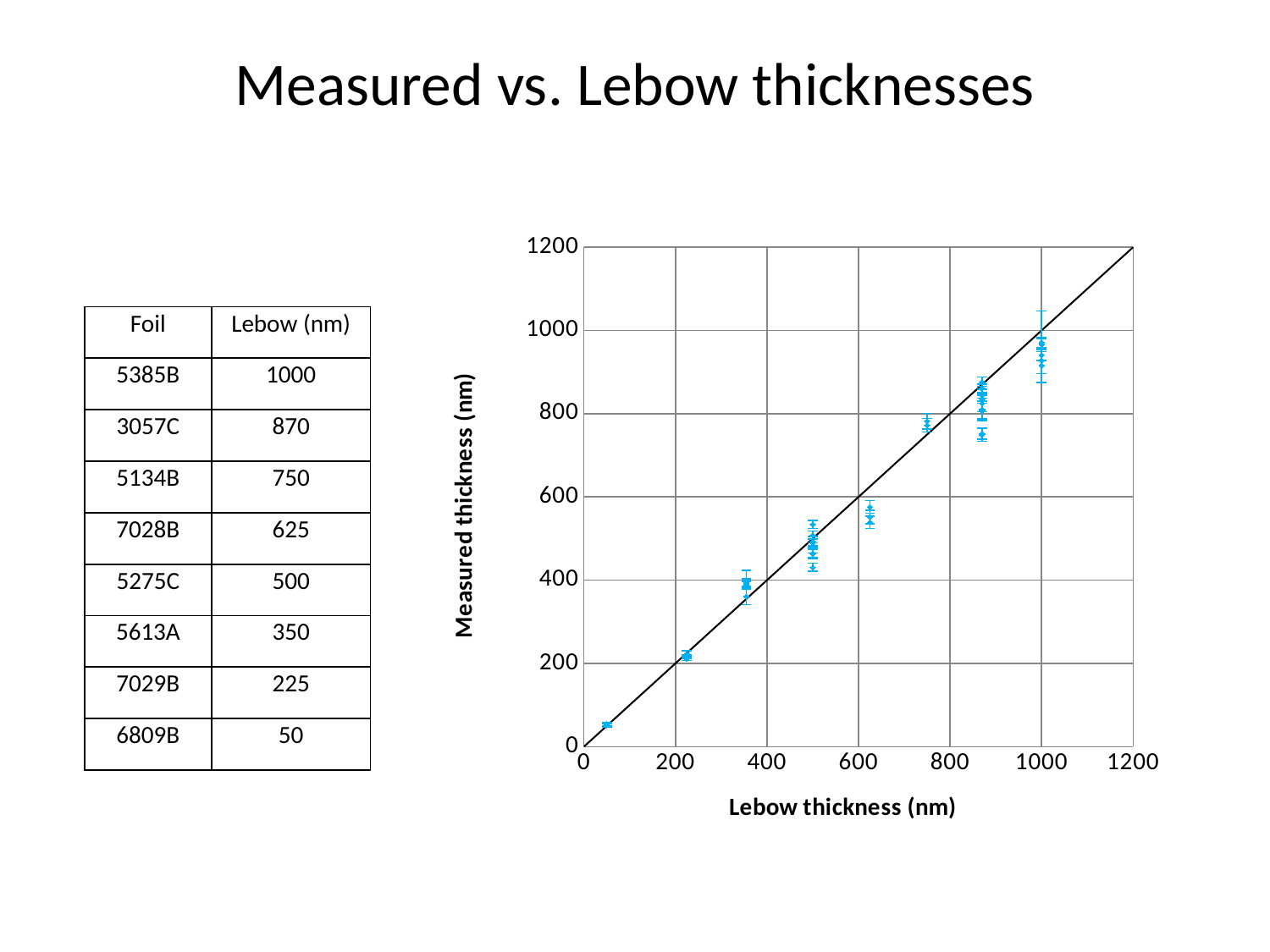
What is the title of the y axis of the chart? Measured thickness (nm) How many distinct Lebow thickness values have points plotted on the chart? 8 Are the measured thickness values at a Lebow thickness of 1000 nm greater or less than 800? greater What is the title of the x axis of the chart? Lebow thickness (nm) Are the measured thickness values at a Lebow thickness of 225 nm greater or less than 400? less Are the measured thickness values at a Lebow thickness of 750 nm greater or less than 600? greater Does the measured thickness rise or fall as the Lebow thickness increases along the x axis? rise What kind of chart is shown on the slide? scatter chart